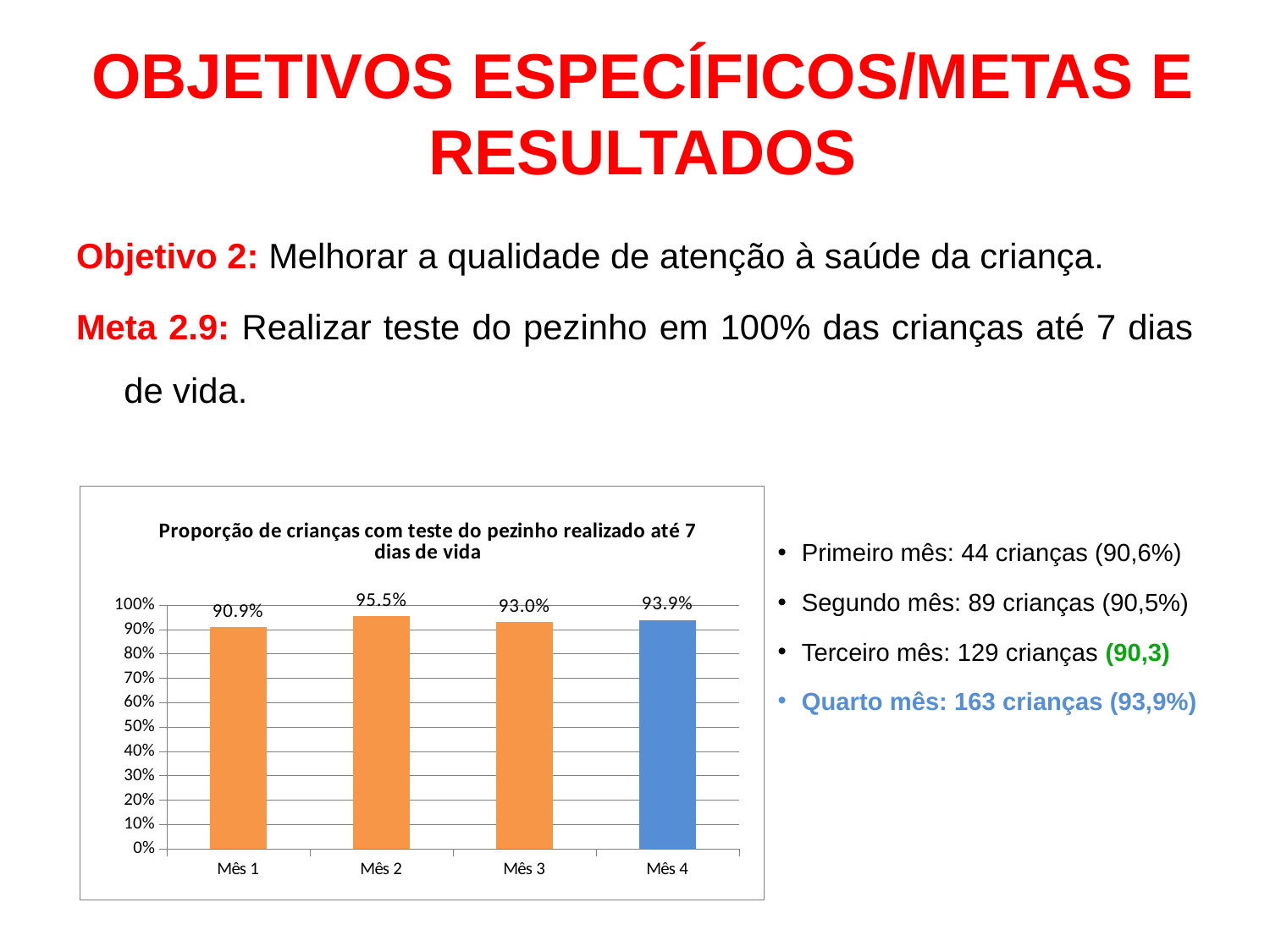
Which is larger, the value for Mês 3 or the value for Mês 4? Mês 4 What is the value for Mês 2? 95.5% Is the value for Mês 2 greater or less than 90%? greater What is the value for Mês 3? 93.0% How many months are shown on the x axis? 4 What is the value for Mês 1? 90.9% What is the title of the chart? Proporção de crianças com teste do pezinho realizado até 7 dias de vida What is the difference between the values for Mês 2 and Mês 1? 4.6% Which month has the lowest value? Mês 1 What is the value for Mês 4? 93.9% What kind of chart is shown on the slide? bar chart Which month has the highest value? Mês 2